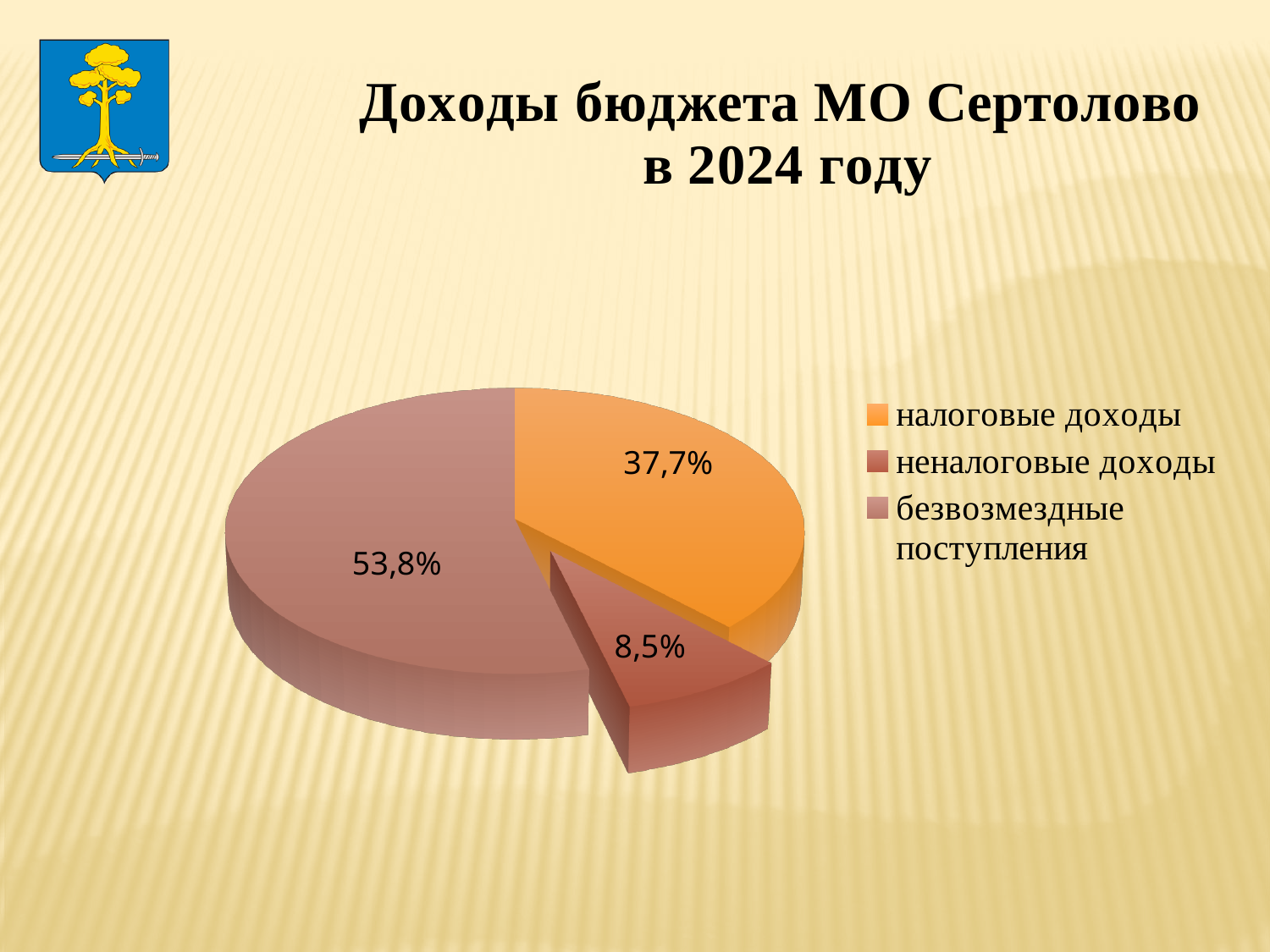
What is the title of the slide containing the chart? Доходы бюджета МО Сертолово в 2024 году How many entries does the legend list? 3 What share of the pie does неналоговые доходы represent? 8,5% What is the difference in percentage points between безвозмездные поступления and налоговые доходы? 16,1 Which is larger: the share for налоговые доходы or the share for неналоговые доходы? налоговые доходы What kind of chart is shown on the slide? pie chart Which category has the smallest share of the pie? неналоговые доходы Which category has the largest share of the pie? безвозмездные поступления What is the difference in percentage points between налоговые доходы and неналоговые доходы? 29,2 What share of the pie does налоговые доходы represent? 37,7% What share of the pie does безвозмездные поступления represent? 53,8% How many slices does the pie chart have? 3